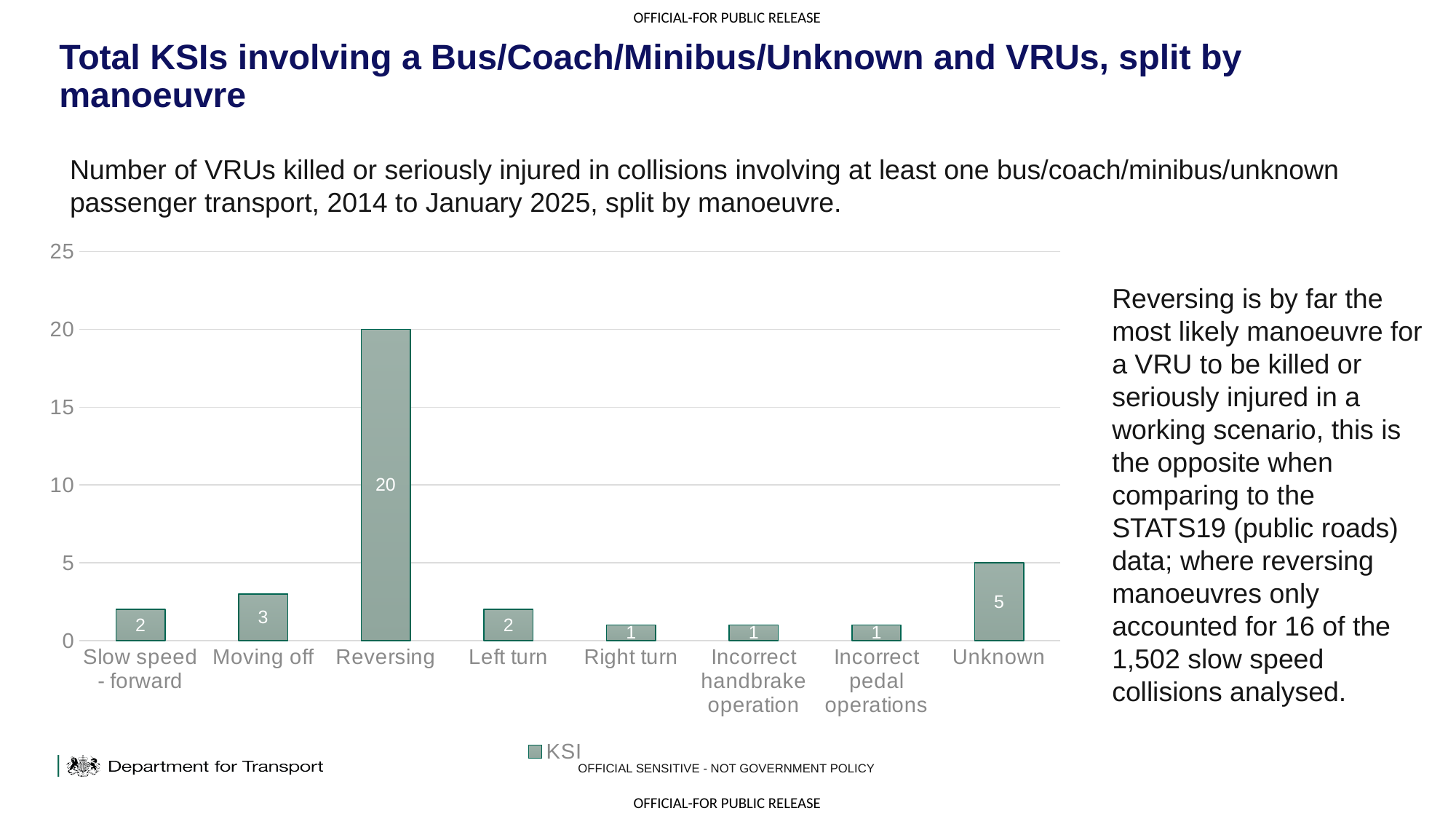
What is the difference between the KSI values for Reversing and Unknown? 15 Which manoeuvre has the highest KSI value? Reversing What is the KSI value for Moving off? 3 Is the value for Reversing greater or less than 15? greater How many manoeuvre categories are shown on the x axis? 8 What is the name of the series shown in the legend? KSI What is the KSI value for Reversing? 20 What is the KSI value for Unknown? 5 What kind of chart is shown on the slide? Bar chart Which has a larger KSI value, Moving off or Left turn? Moving off What is the KSI value for Incorrect handbrake operation? 1 How many series does the legend list? 1